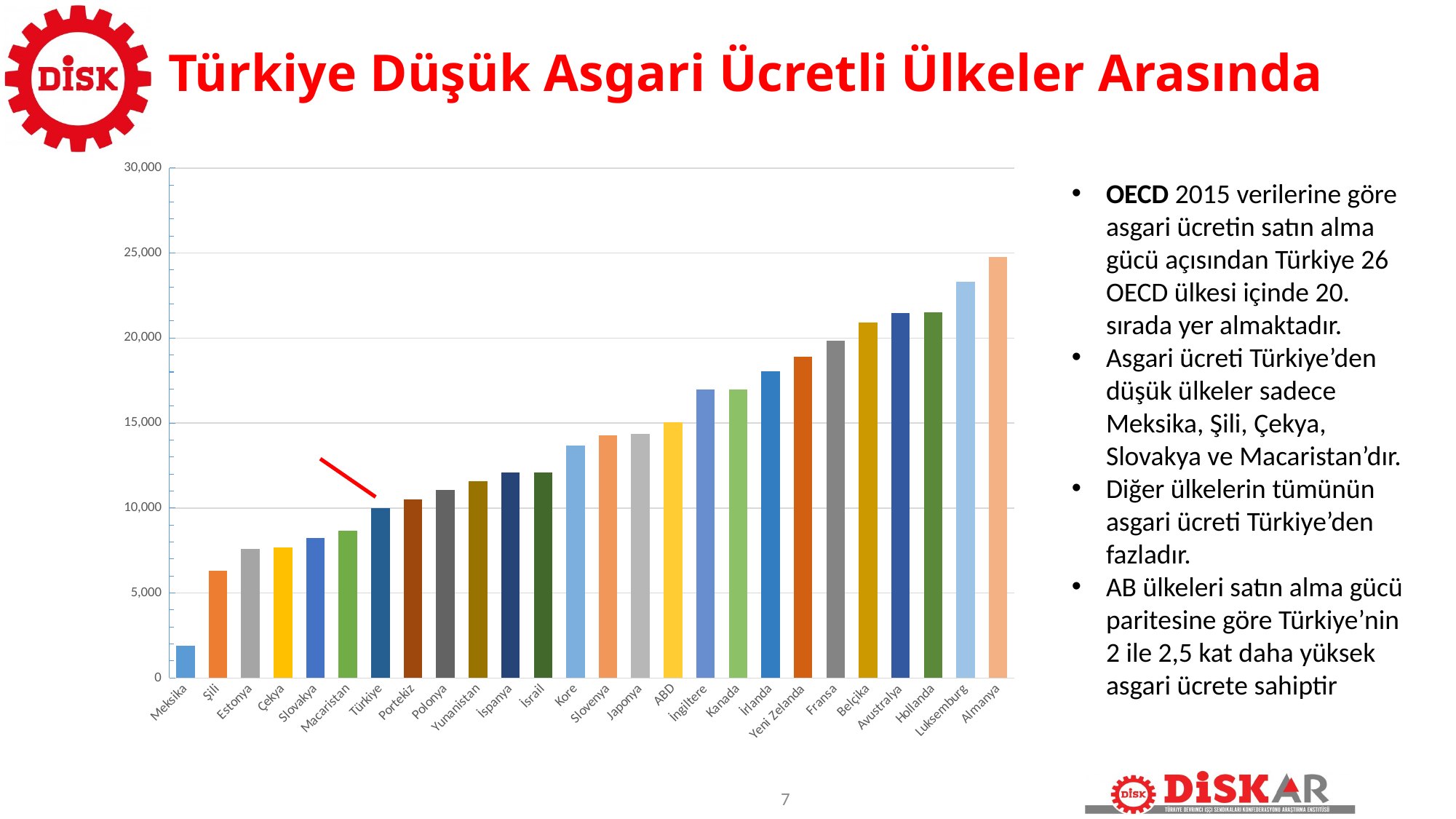
What kind of chart is shown on the slide? bar chart Which country has the lowest bar in the chart? Meksika Which has the larger value, Şili or Estonya? Estonya Is the value for Kore greater or less than 15,000? less Is the value for Almanya greater or less than 20,000? greater Which country has the highest bar in the chart? Almanya Do the bar values rise or fall from left to right along the x axis? rise Which has the larger value, Fransa or Kore? Fransa How many countries are shown on the x axis of the chart? 26 Is the value for Luksemburg greater or less than 20,000? greater Which country's bar does the red arrow on the chart point to? Türkiye